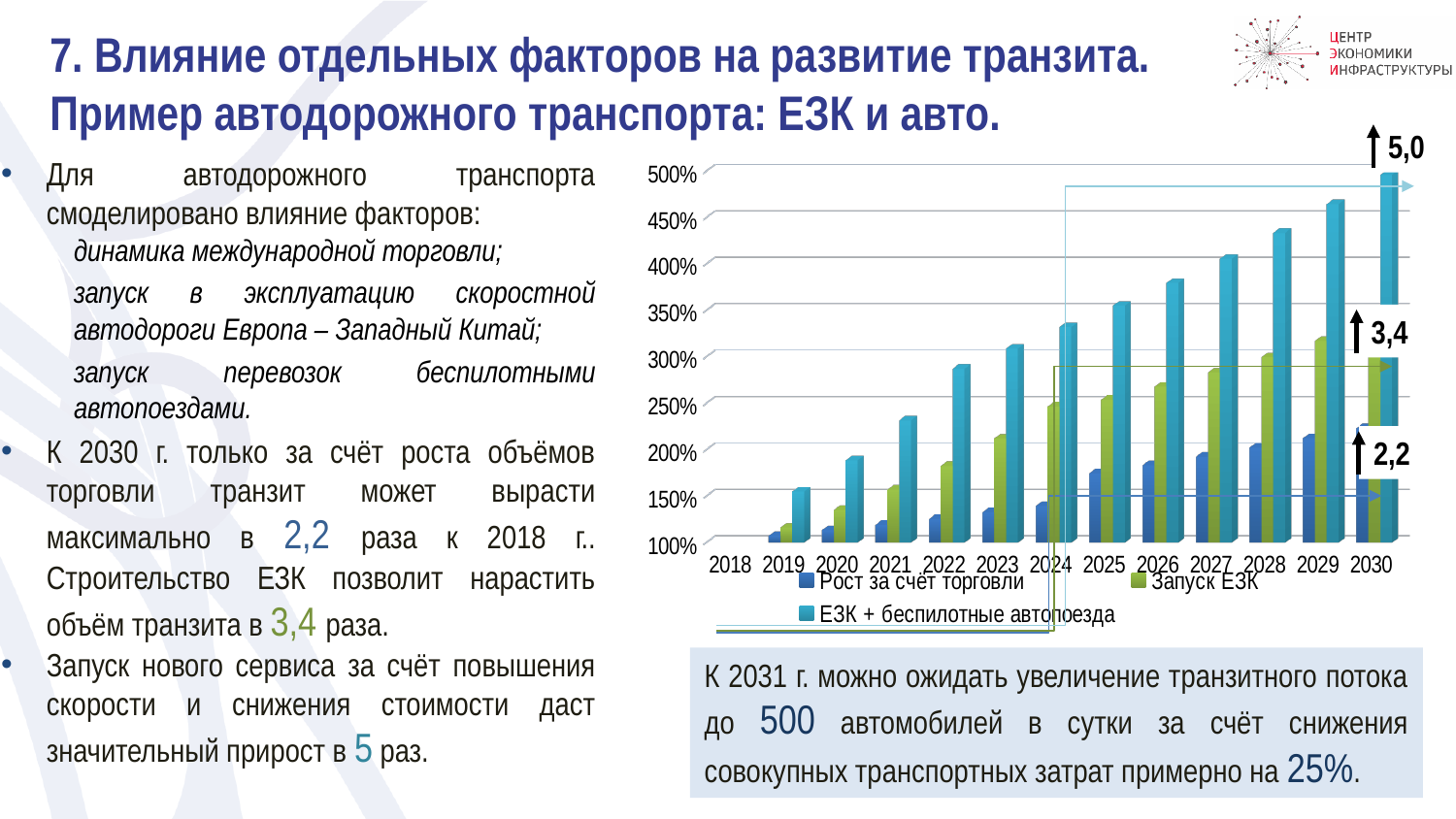
In 2030, which series has the larger value: 'Запуск ЕЗК' or 'ЕЗК + беспилотные автопоезда'? ЕЗК + беспилотные автопоезда Is the value for 'Запуск ЕЗК' in 2022 greater or less than 200%? less What is the first series listed in the chart legend? Рост за счёт торговли Is the value for 'ЕЗК + беспилотные автопоезда' in 2021 greater or less than 200%? greater What is the lowest value shown on the chart's y axis? 100% Do the values for 'ЕЗК + беспилотные автопоезда' rise or fall from 2018 to 2030? rise Is the value for 'Рост за счёт торговли' in 2029 greater or less than 200%? greater How many years are shown on the x axis of the chart? 13 What kind of chart is shown on the slide? bar chart How many series does the chart legend list? 3 Which year has the highest value for the series 'ЕЗК + беспилотные автопоезда'? 2030